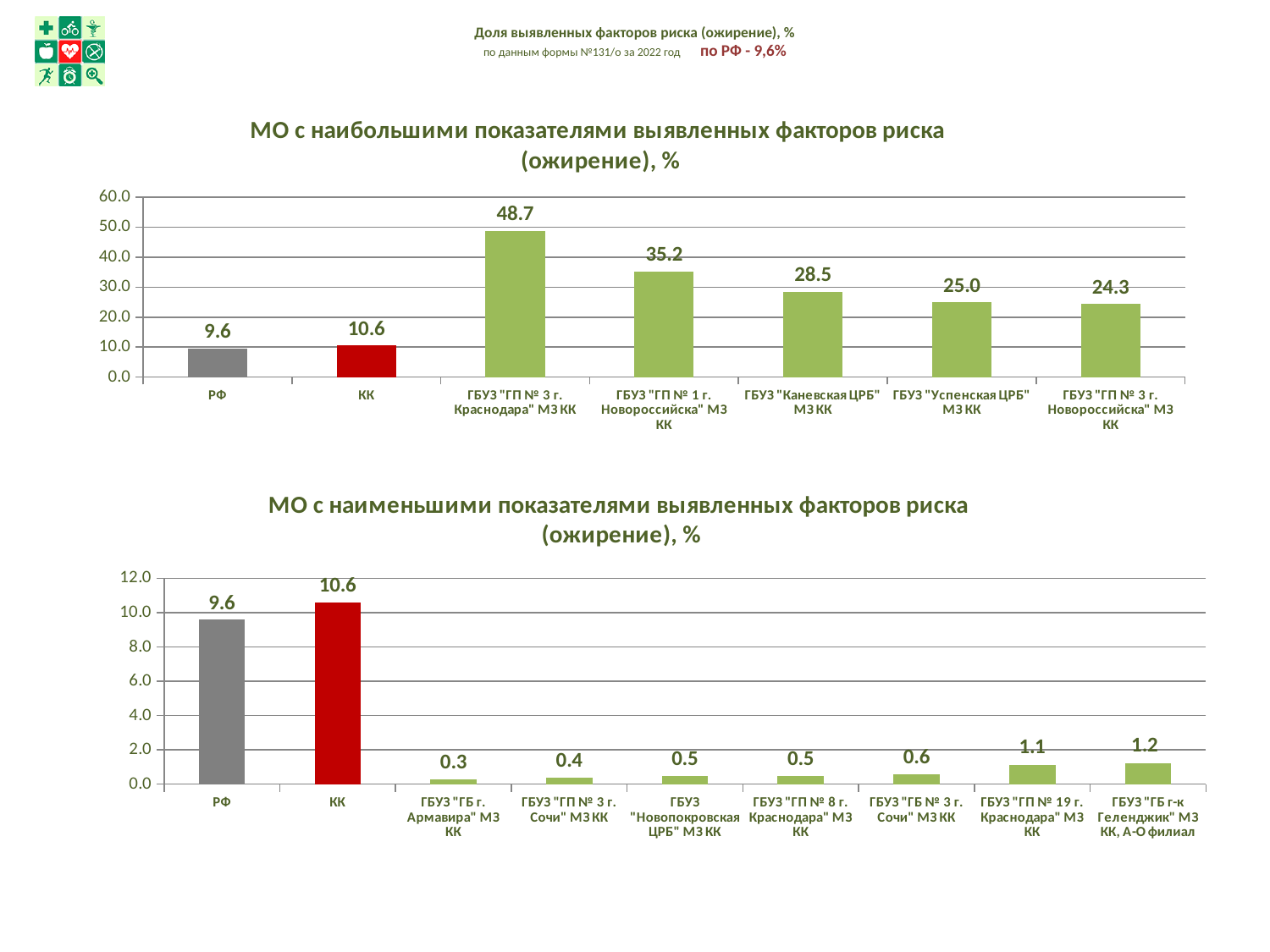
In the top chart (МО с наибольшими показателями), which is larger: the value for КК or the value for РФ? КК In the top chart (МО с наибольшими показателями), what is the difference between ГБУЗ "ГП № 1 г. Новороссийска" МЗ КК and ГБУЗ "Каневская ЦРБ" МЗ КК? 6.7 What type of chart is the bottom chart (МО с наименьшими показателями)? Bar chart In the top chart (МО с наибольшими показателями), which category has the highest value? ГБУЗ "ГП № 3 г. Краснодара" МЗ КК In the bottom chart (МО с наименьшими показателями), what is the difference between КК and ГБУЗ "ГП № 19 г. Краснодара" МЗ КК? 9.5 In the bottom chart (МО с наименьшими показателями), which category has the lowest value? ГБУЗ "ГБ г. Армавира" МЗ КК In the bottom chart (МО с наименьшими показателями), how many categories are shown on the x axis? 9 In the top chart (МО с наибольшими показателями), what is the value for ГБУЗ "Успенская ЦРБ" МЗ КК? 25.0 In the bottom chart (МО с наименьшими показателями), what is the value for ГБУЗ "ГБ г-к Геленджик" МЗ КК, А-О филиал? 1.2 In the bottom chart (МО с наименьшими показателями), what is the value for ГБУЗ "ГБ г. Армавира" МЗ КК? 0.3 In the top chart (МО с наибольшими показателями), what is the value for ГБУЗ "ГП № 3 г. Краснодара" МЗ КК? 48.7 In the top chart (МО с наибольшими показателями), how many bars are plotted? 7